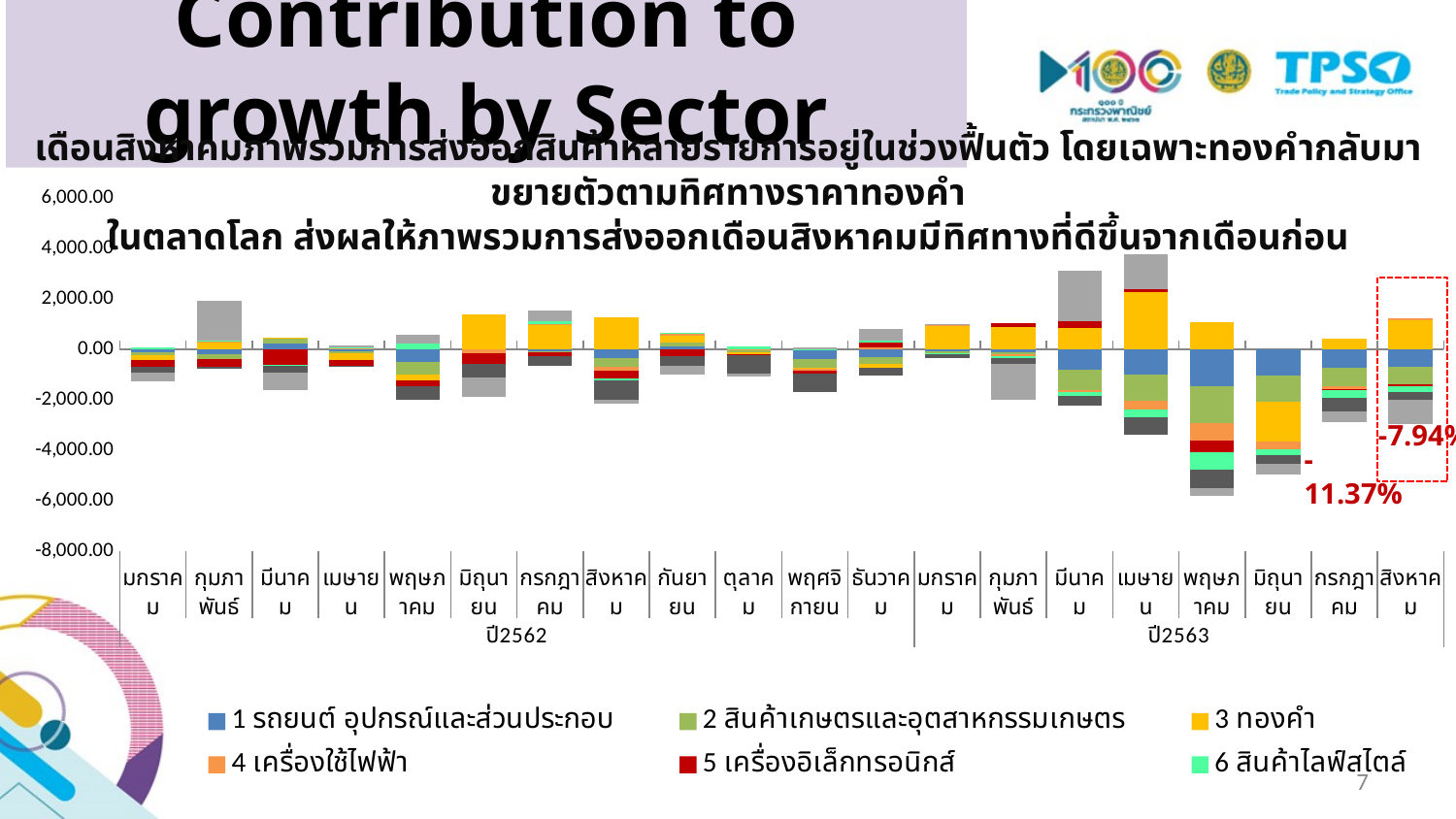
Is the top of the stacked bar for มีนาคม ปี2563 greater or less than 2,000.00? greater How many series does the chart legend list? 6 What percentage is annotated for กรกฎาคม ปี2563? -11.37% Which month's stacked bar reaches highest above zero? มีนาคม ปี2563 What is the highest tick value shown on the y axis? 6,000.00 What kind of chart is shown on the slide? Stacked bar chart Which two years are labelled on the x axis? ปี2562 and ปี2563 Which month's stacked bar extends lowest below zero? พฤษภาคม ปี2563 Is the bottom of the stacked bar for พฤษภาคม ปี2563 greater or less than -4,000.00? less What percentage is annotated in the dashed red box for สิงหาคม ปี2563? -7.94% What colour represents the series 3 ทองคำ in the legend? Yellow How many months (categories) are plotted along the x axis? 20